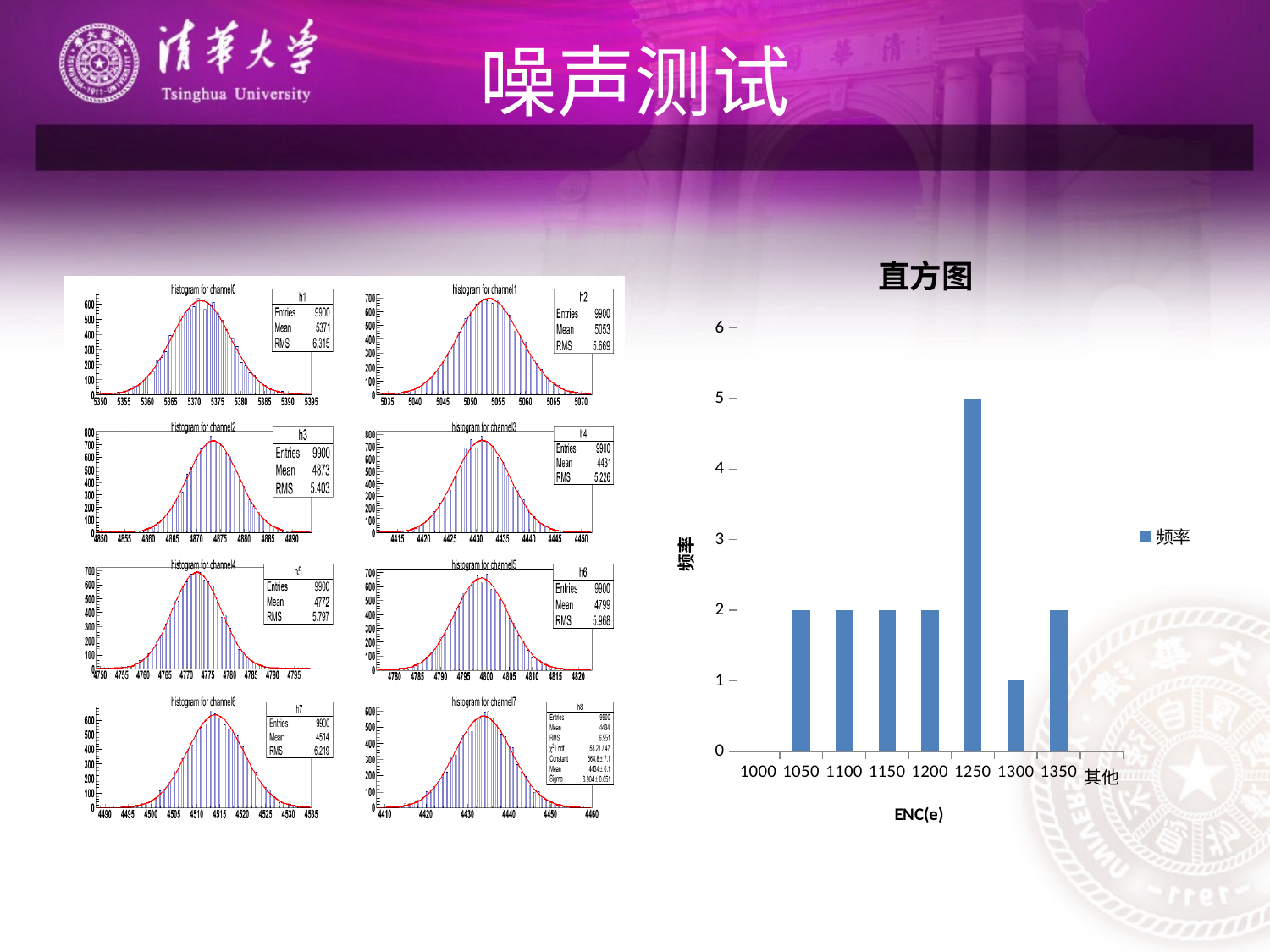
In the bar chart titled 直方图, how many series does the legend list? 1 In the bar chart titled 直方图, what is the difference between the values for 1250 and 1300? 4 In the bar chart titled 直方图, what is the value for the 1300 category? 1 In the bar chart titled 直方图, what is the x-axis label? ENC(e) In the bar chart titled 直方图, which category with a visible bar has the lowest value? 1300 In the bar chart titled 直方图, what is the value for the 1050 category? 2 In the histogram for channel0 on the left of the slide, what is the Mean shown in the stats box? 5371 What kind of chart is the chart titled 直方图? bar chart In the bar chart titled 直方图, which is larger, the value for 1250 or the value for 1350? 1250 In the bar chart titled 直方图, which category has the highest value? 1250 In the bar chart titled 直方图, what is the value for the 1250 category? 5 In the bar chart titled 直方图, how many categories are shown on the x axis? 9